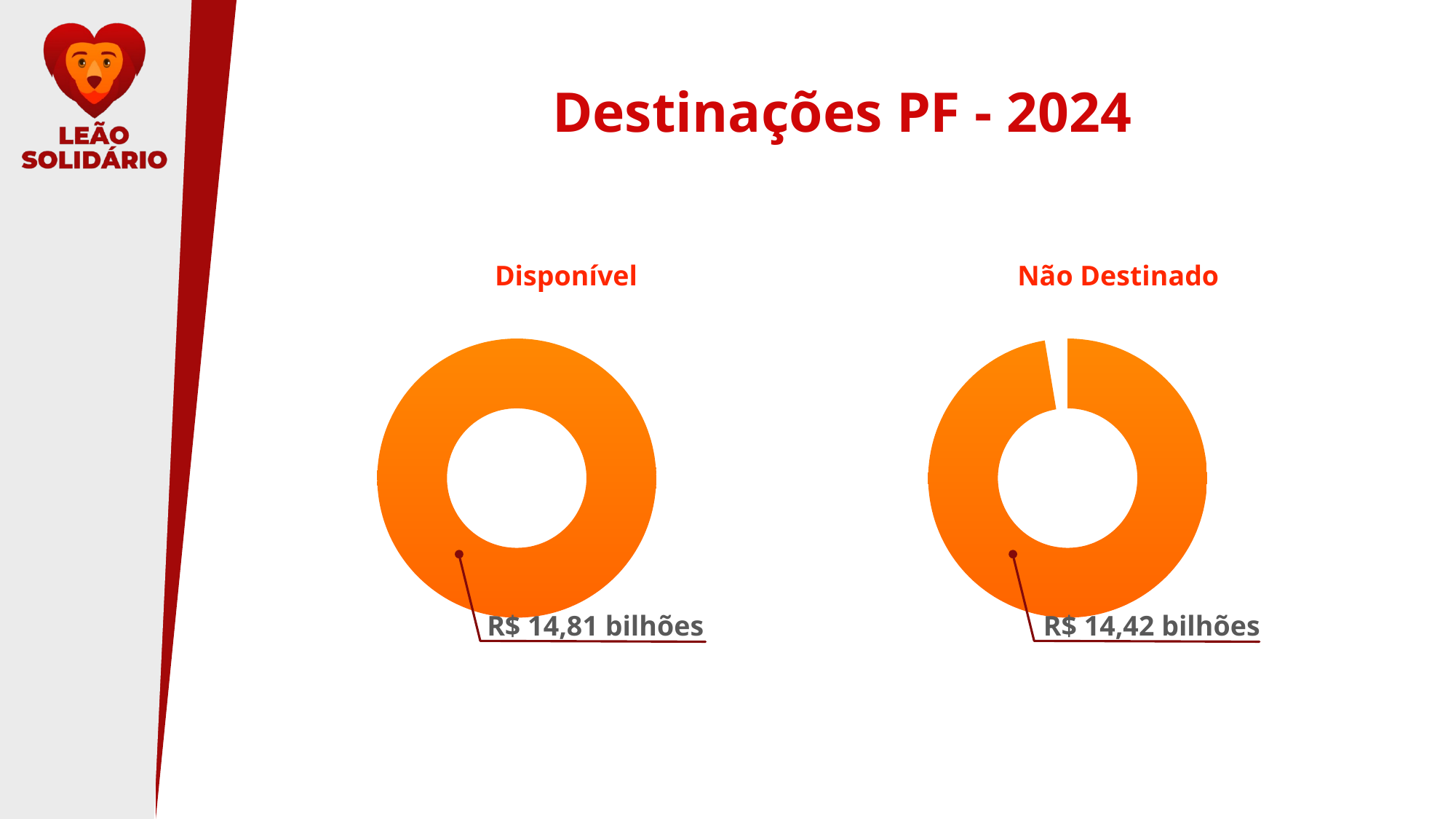
Which chart shows the larger labelled value, Disponível or Não Destinado? Disponível What kind of chart is the Não Destinado chart? Doughnut chart On the Não Destinado chart, what value is shown by the data label? R$ 14,42 bilhões On the Disponível chart, what value is shown by the data label? R$ 14,81 bilhões Is the labelled value on the Não Destinado chart greater or less than R$ 14,81 bilhões? less What kind of chart is the Disponível chart? Doughnut chart What is the title of the slide containing the two charts? Destinações PF - 2024 How many charts are shown on the slide? 2 What is the difference between the labelled value on the Disponível chart and the labelled value on the Não Destinado chart? R$ 0,39 bilhões What colour are the rings of the two doughnut charts? Orange